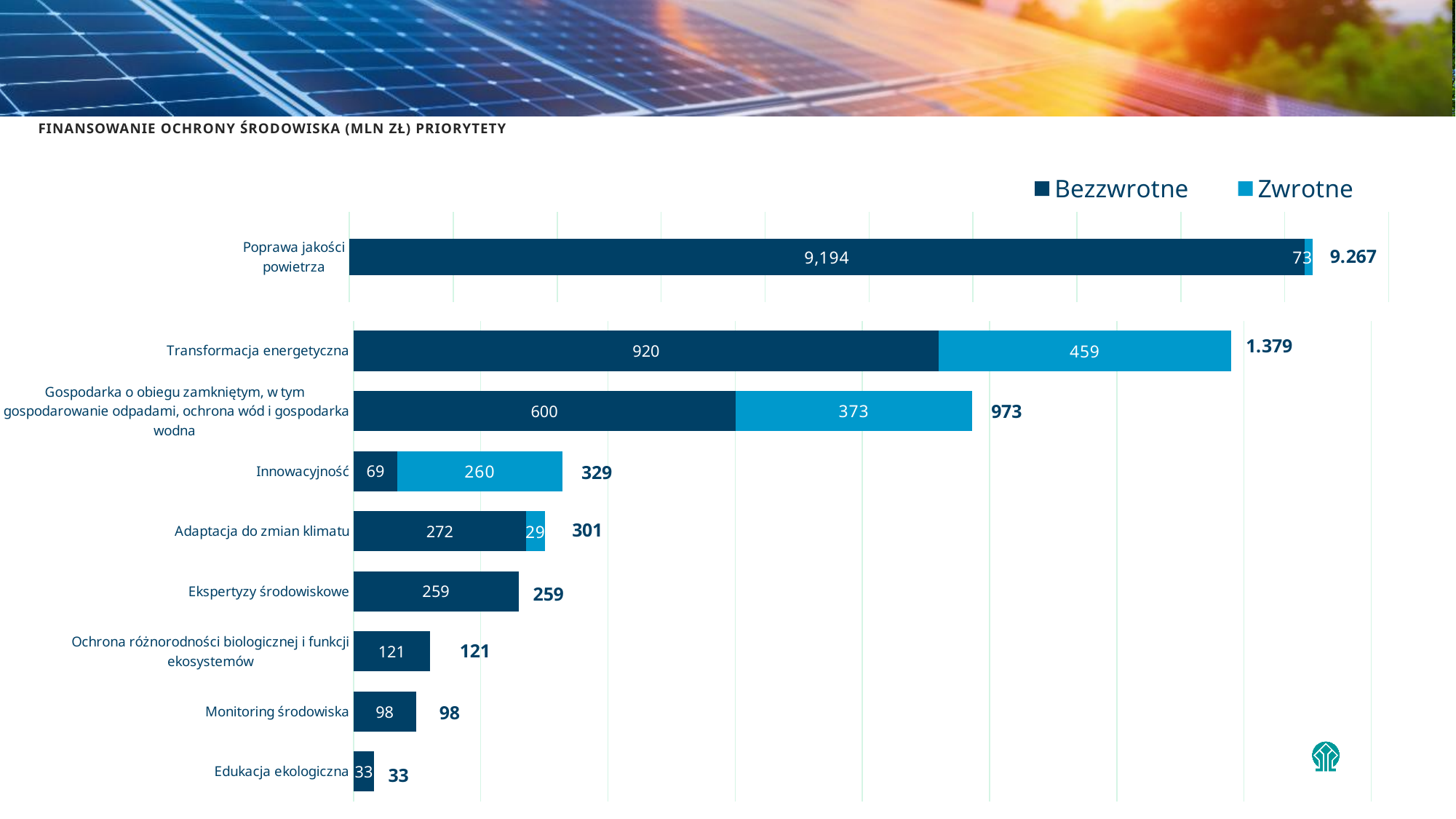
Which is larger for Adaptacja do zmian klimatu, the Bezzwrotne value or the Zwrotne value? Bezzwrotne How many series does the legend list? 2 What is the Bezzwrotne value for Transformacja energetyczna? 920 What is the Zwrotne value for Innowacyjność? 260 What is the title of the chart? FINANSOWANIE OCHRONY ŚRODOWISKA (MLN ZŁ) PRIORYTETY What is the total shown for Poprawa jakości powietrza? 9.267 What kind of chart is shown on the slide? Stacked bar chart What is the difference between the Bezzwrotne and Zwrotne values for Transformacja energetyczna? 461 How many categories are shown on the chart? 9 Which category has the lowest total? Edukacja ekologiczna Which category has the highest total? Poprawa jakości powietrza What is the total shown for Gospodarka o obiegu zamkniętym, w tym gospodarowanie odpadami, ochrona wód i gospodarka wodna? 973